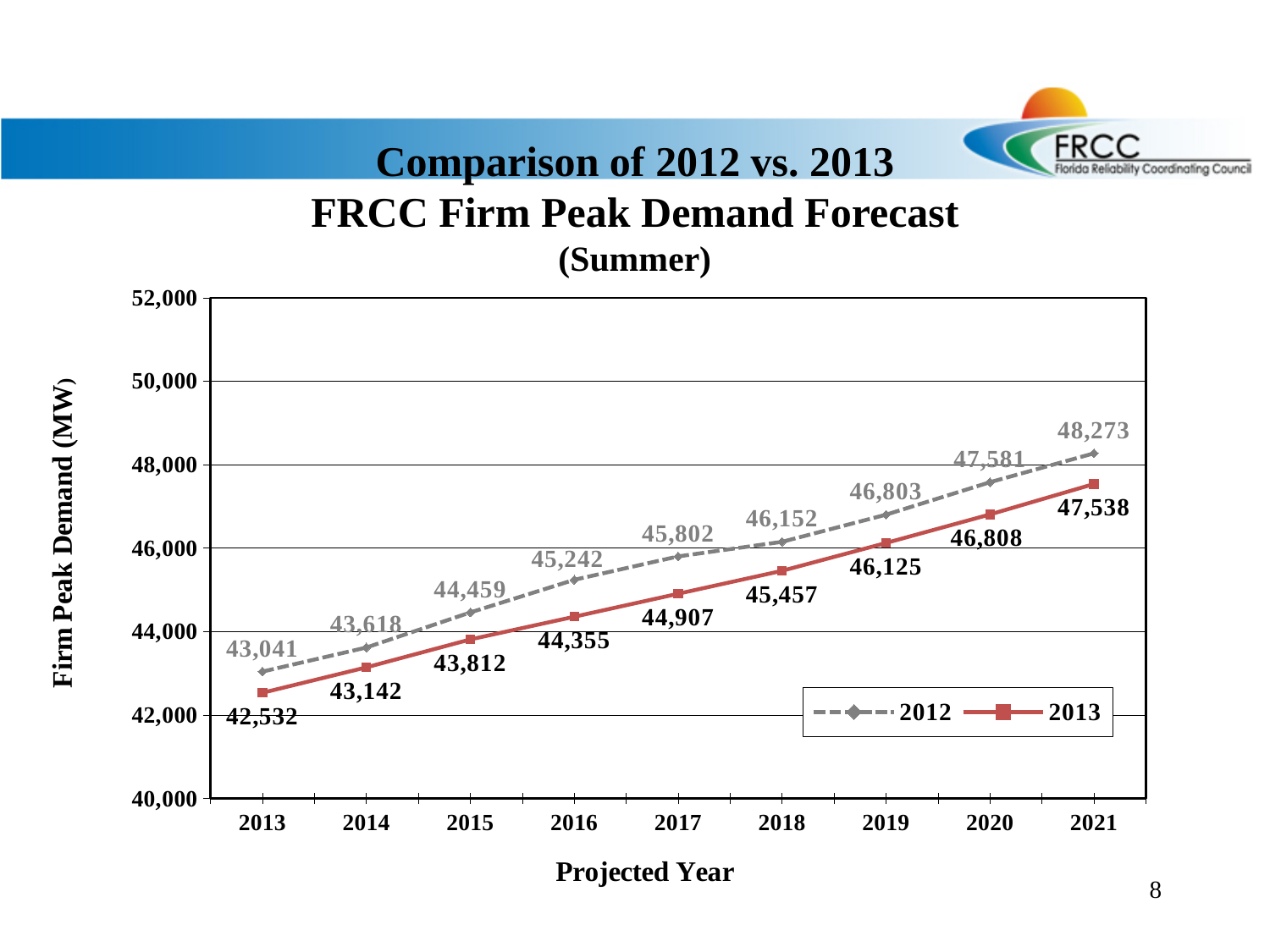
How many series does the legend list? 2 What is the 2012 forecast value for projected year 2013? 43,041 Which projected year has the lowest value in the 2013 series? 2013 What kind of chart is shown on the slide? Line chart What is the 2013 forecast value for projected year 2021? 47,538 Do the values of the 2013 series rise or fall from 2013 to 2021? Rise Which series has the larger value for projected year 2019, 2012 or 2013? 2012 Which projected year has the highest value in the 2012 series? 2021 How many projected years are shown on the x axis? 9 What is the 2013 forecast value for projected year 2018? 45,457 What is the difference between the 2012 and 2013 forecasts for projected year 2021? 735 What is the 2012 forecast value for projected year 2016? 45,242